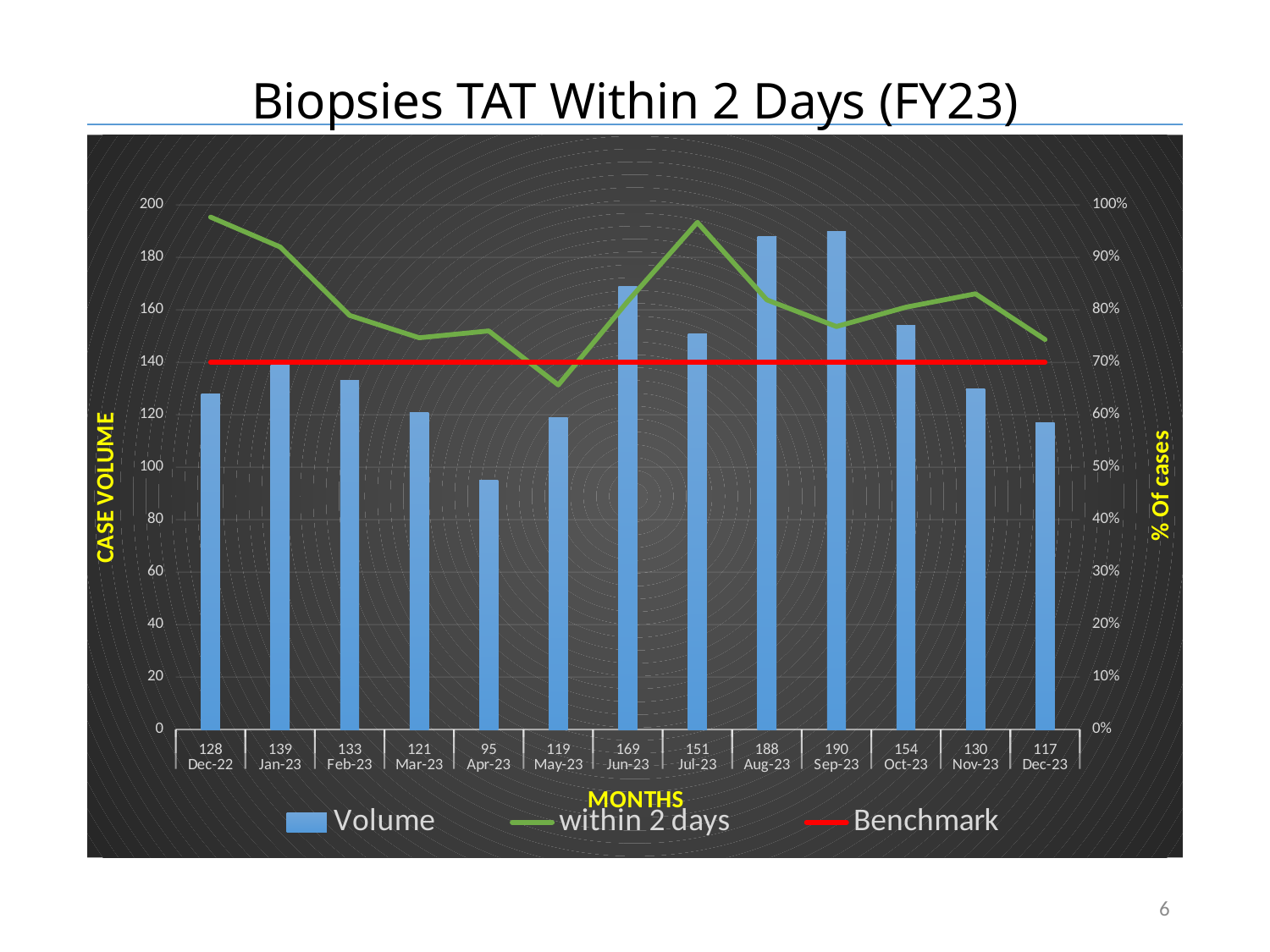
What is the case volume for Apr-23? 95 Does the case volume rise or fall from Dec-22 to Apr-23? fall What is the difference in case volume between Sep-23 and Apr-23? 95 How many months are shown on the x axis? 13 Which month has the highest case volume? Sep-23 How many series does the legend list? 3 What is the title of the chart? Biopsies TAT Within 2 Days (FY23) Which month has the lowest case volume? Apr-23 Is the 'within 2 days' percentage for May-23 greater or less than 70%? less What is the case volume for Sep-23? 190 Is the 'within 2 days' percentage for Dec-22 greater or less than 90%? greater Which month has the larger case volume, Jun-23 or Jul-23? Jun-23